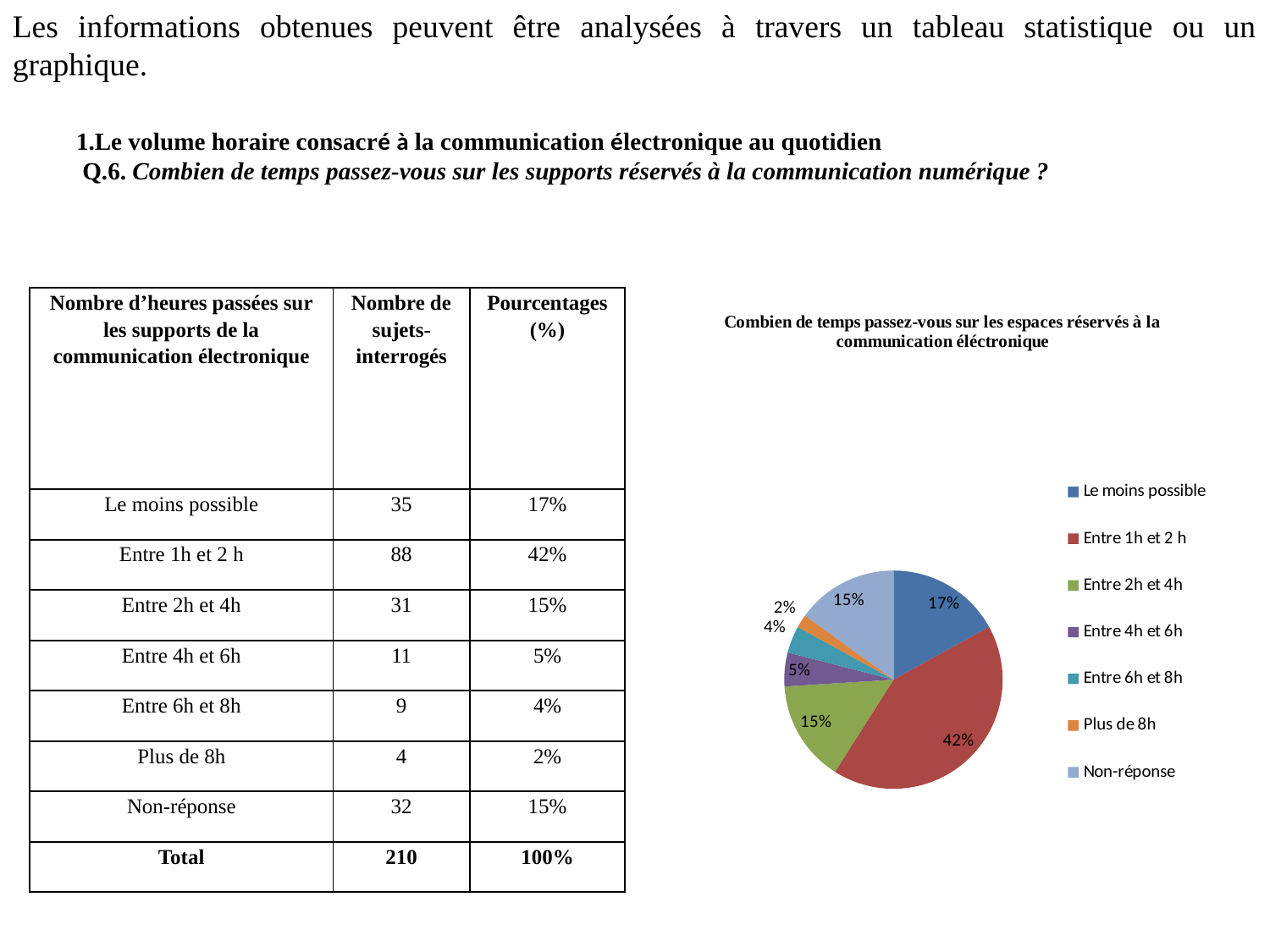
What percentage does the pie chart show for 'Entre 1h et 2 h'? 42% How many slices does the pie chart have? 7 In the pie chart, what is the difference in percentage points between 'Entre 1h et 2 h' and 'Le moins possible'? 25 How many entries does the legend of the pie chart list? 7 What kind of chart is shown on the slide? pie chart What percentage does the pie chart show for 'Entre 6h et 8h'? 4% Which category has the smallest slice in the pie chart? Plus de 8h In the pie chart, which is larger: the slice for 'Entre 4h et 6h' or the slice for 'Entre 6h et 8h'? Entre 4h et 6h What percentage does the pie chart show for 'Plus de 8h'? 2% What percentage does the pie chart show for 'Le moins possible'? 17% What is the title of the pie chart? Combien de temps passez-vous sur les espaces réservés à la communication éléctronique Which category has the largest slice in the pie chart? Entre 1h et 2 h